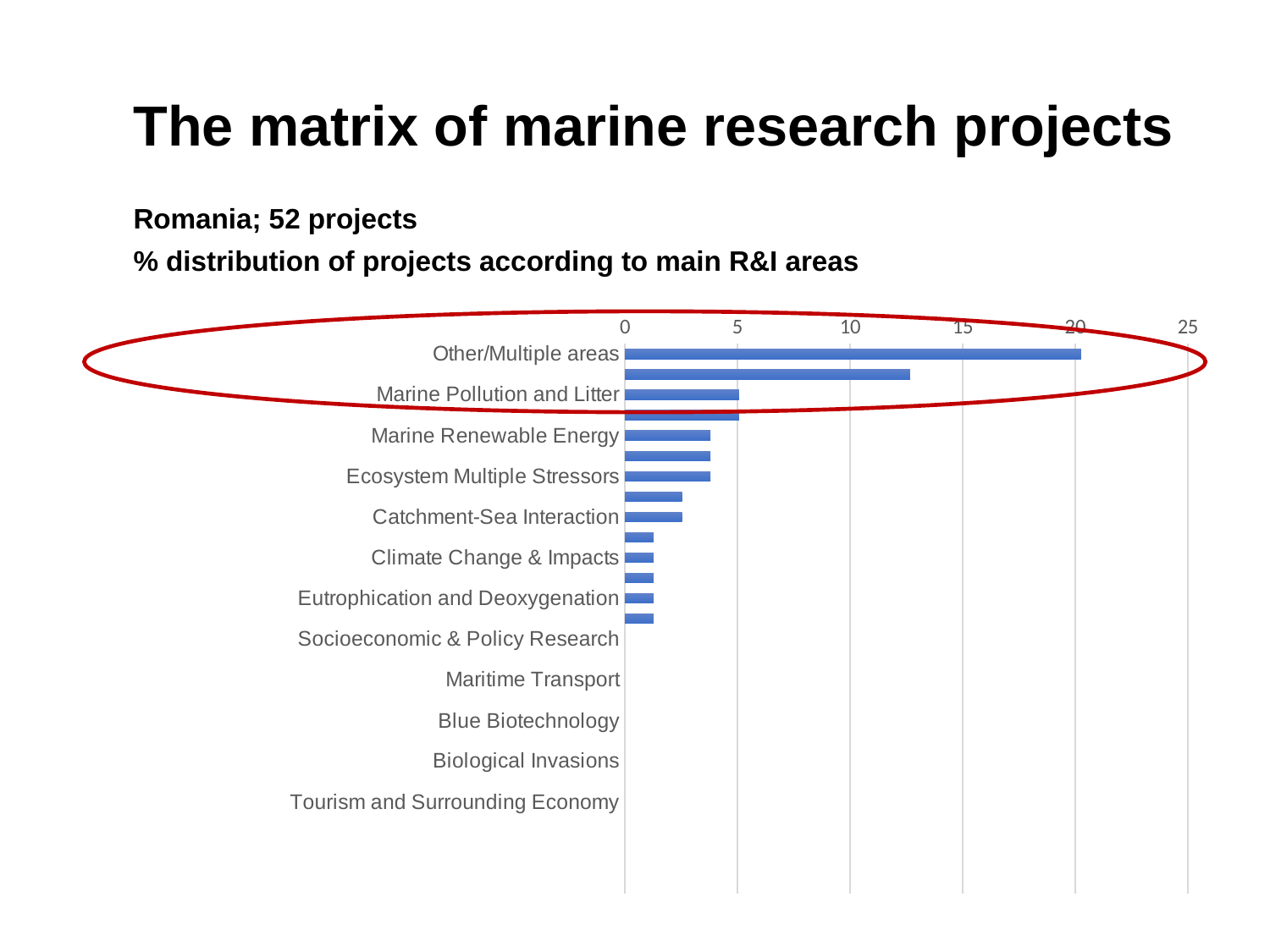
Is the value for Catchment-Sea Interaction greater or less than 5? less Which category has the highest value in the chart? Other/Multiple areas Is the value for Marine Pollution and Litter greater or less than 10? less Which is larger, the value for Other/Multiple areas or the value for Marine Pollution and Litter? Other/Multiple areas Is the value for Other/Multiple areas greater or less than 15? greater What kind of chart is shown on the slide? bar chart What is the highest tick value shown on the horizontal axis? 25 Do the bar values rise or fall going from the top category to the bottom category? fall Which is larger, the value for Marine Renewable Energy or the value for Eutrophication and Deoxygenation? Marine Renewable Energy